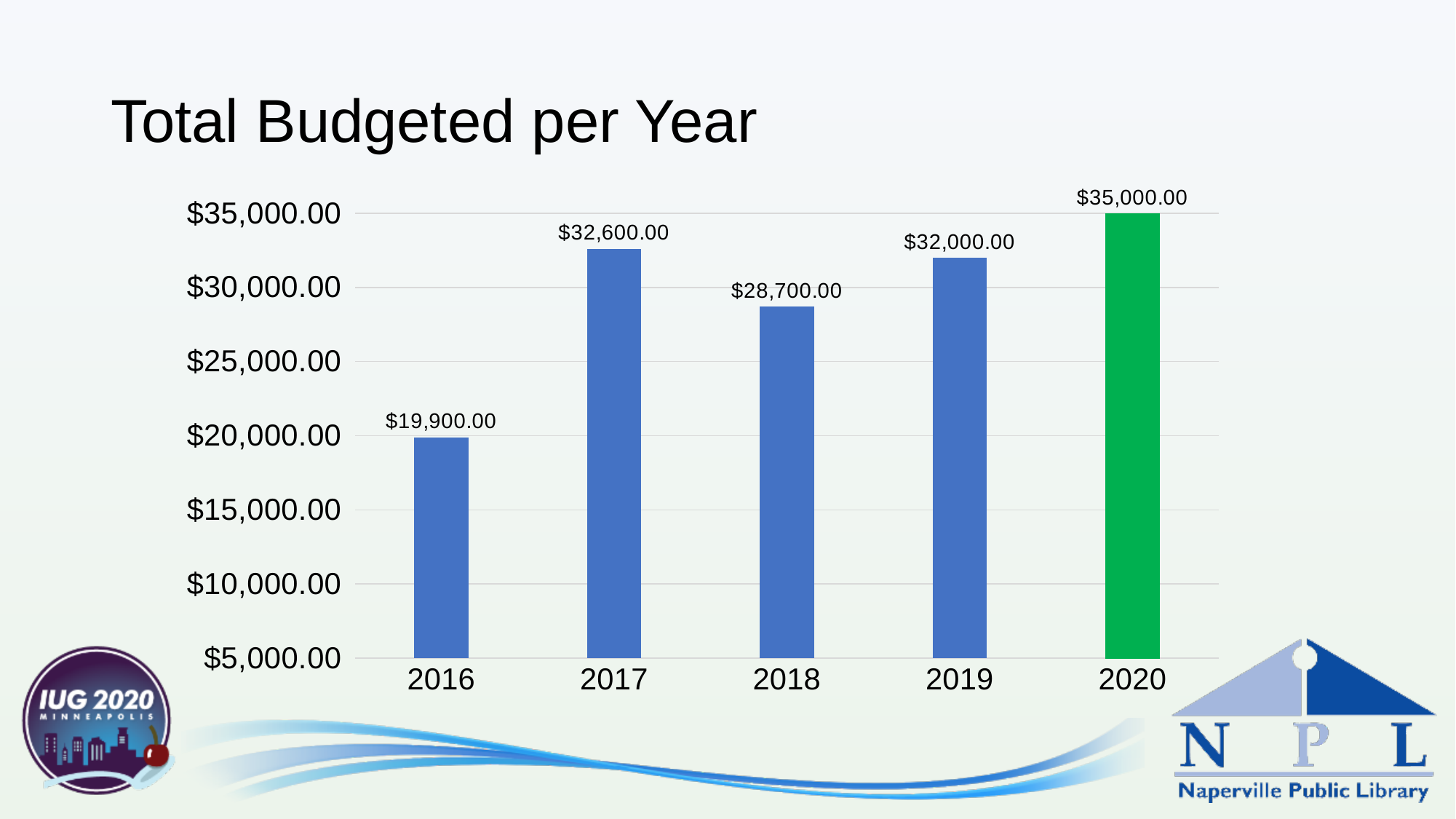
Which bar is coloured green rather than blue? 2020 What is the difference between the total budgeted in 2017 and in 2019? $600.00 Which year has the lowest total budgeted? 2016 What kind of chart is shown on the slide? bar chart What is the difference between the total budgeted in 2020 and in 2016? $15,100.00 Which year has a larger total budgeted, 2017 or 2018? 2017 Which year has the highest total budgeted? 2020 What is the total budgeted for 2016? $19,900.00 What is the total budgeted for 2018? $28,700.00 What is the total budgeted for 2020? $35,000.00 Is the value for 2018 greater or less than $30,000.00? less How many years are shown on the chart? 5